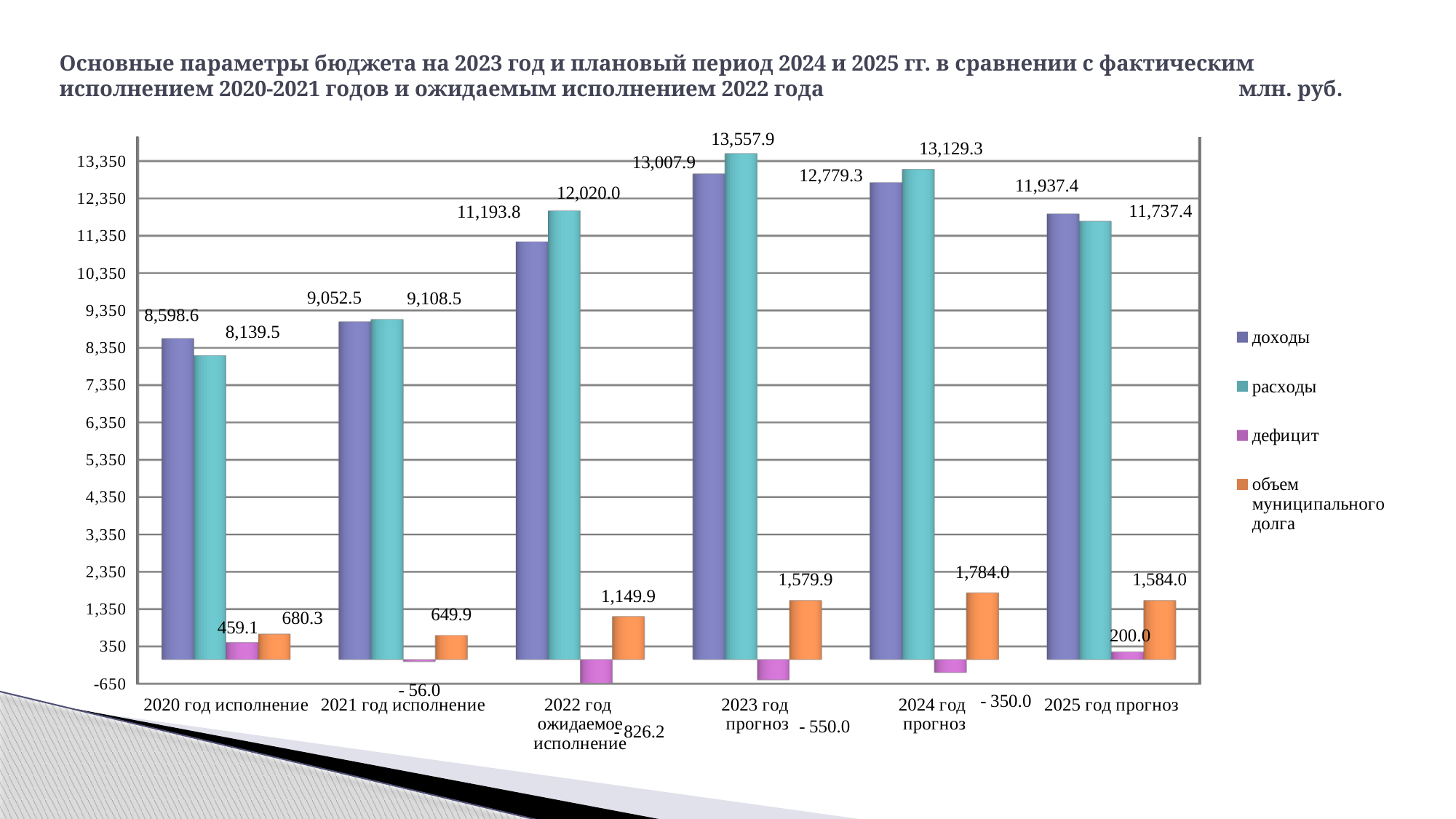
How many year categories are shown along the x axis? 6 Which is larger for 2025 год прогноз: доходы or расходы? доходы In which year category is доходы the lowest? 2020 год исполнение What is the difference between расходы and доходы for 2023 год прогноз? 550.0 What is the value of расходы for 2022 год ожидаемое исполнение? 12,020.0 What is the value of объем муниципального долга for 2024 год прогноз? 1,784.0 What is the value of доходы for 2023 год прогноз? 13,007.9 In which year category is расходы the highest? 2023 год прогноз What is the value of дефицит for 2021 год исполнение? - 56.0 Which series is shown in orange in the legend? объем муниципального долга How many series does the legend list? 4 What type of chart is shown on the slide? Bar chart